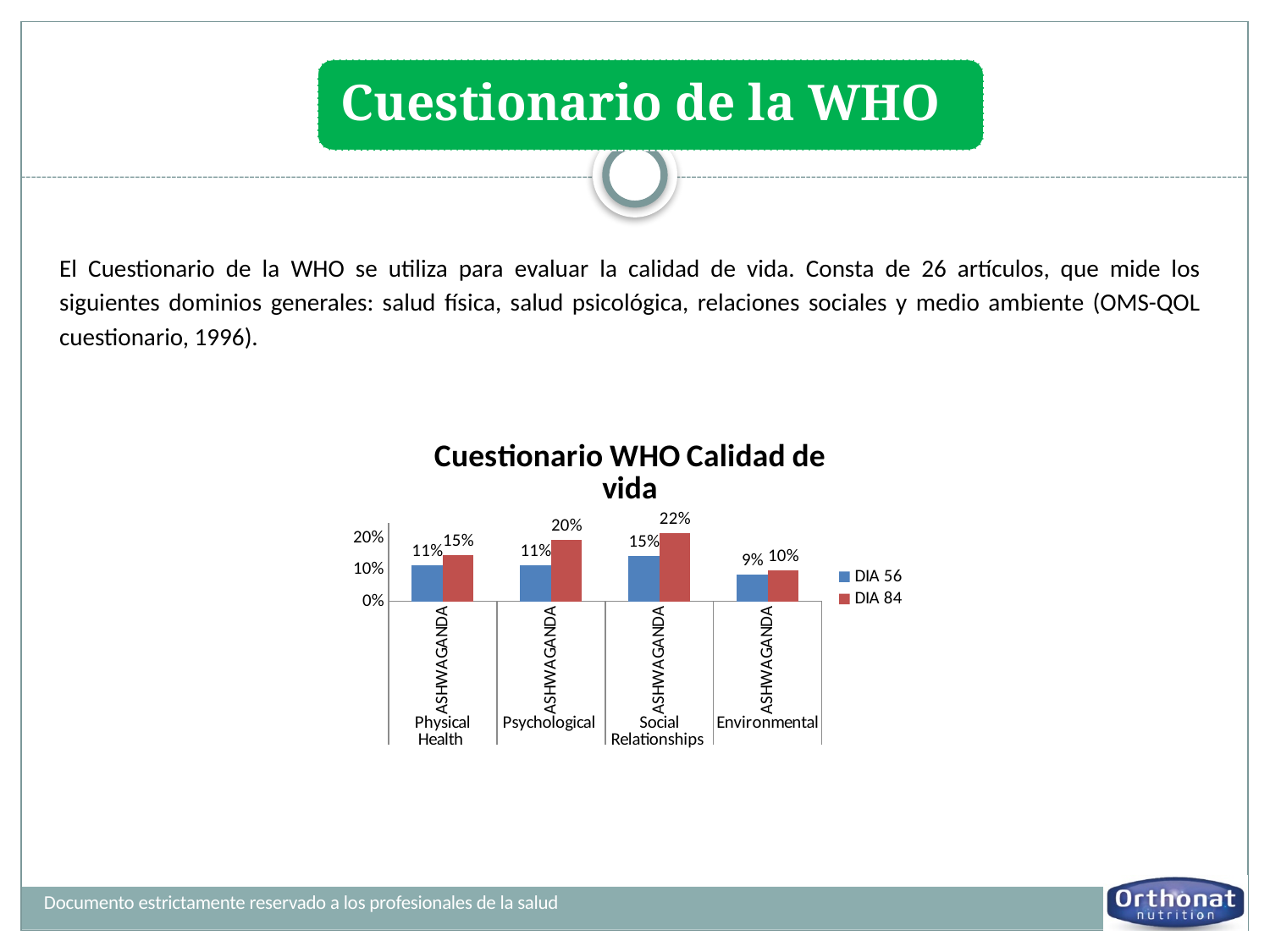
What is the difference between the DIA 84 and DIA 56 values for Social Relationships? 7% How many categories are shown on the x axis? 4 Which category has the highest DIA 84 value? Social Relationships What is the difference between the DIA 84 and DIA 56 values for Psychological? 9% Which category has the lowest DIA 56 value? Environmental What is the title of the chart? Cuestionario WHO Calidad de vida What is the DIA 56 value for Social Relationships? 15% What kind of chart is shown? Bar chart What is the DIA 84 value for Environmental? 10% What is the DIA 84 value for Psychological? 20% How many series does the legend list? 2 Which is larger for Physical Health, the DIA 56 value or the DIA 84 value? DIA 84